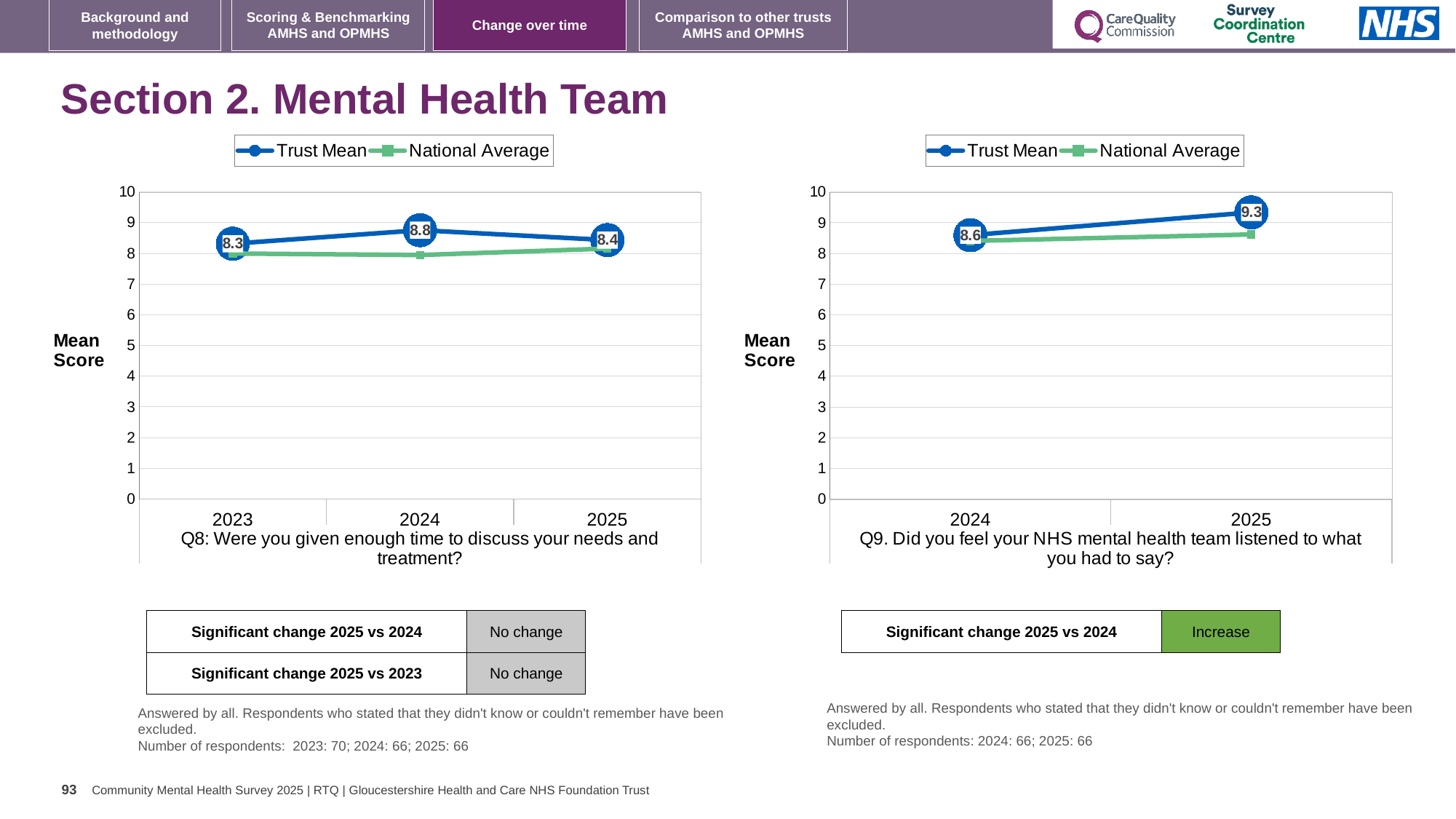
In the Q9 chart (right), what is the Trust Mean for 2025? 9.3 In the Q8 chart (left), which year has the highest Trust Mean? 2024 In the Q8 chart (left), what is the Trust Mean for 2024? 8.8 In the Q8 chart (left), which year has the lowest Trust Mean? 2023 In the Q9 chart (right), what is the difference between the Trust Mean for 2025 and 2024? 0.7 How many years are shown on the x axis of the Q8 chart (left)? 3 In the Q9 chart (right), does the Trust Mean rise or fall from 2024 to 2025? Rise In the Q8 chart (left), is the Trust Mean for 2024 larger than the Trust Mean for 2025? Yes What kind of chart is the Q9 chart (right)? Line chart How many series does the legend of the Q9 chart (right) list? 2 In the Q8 chart (left), what is the Trust Mean for 2023? 8.3 In the Q9 chart (right), is the National Average for 2025 greater or less than 9? less